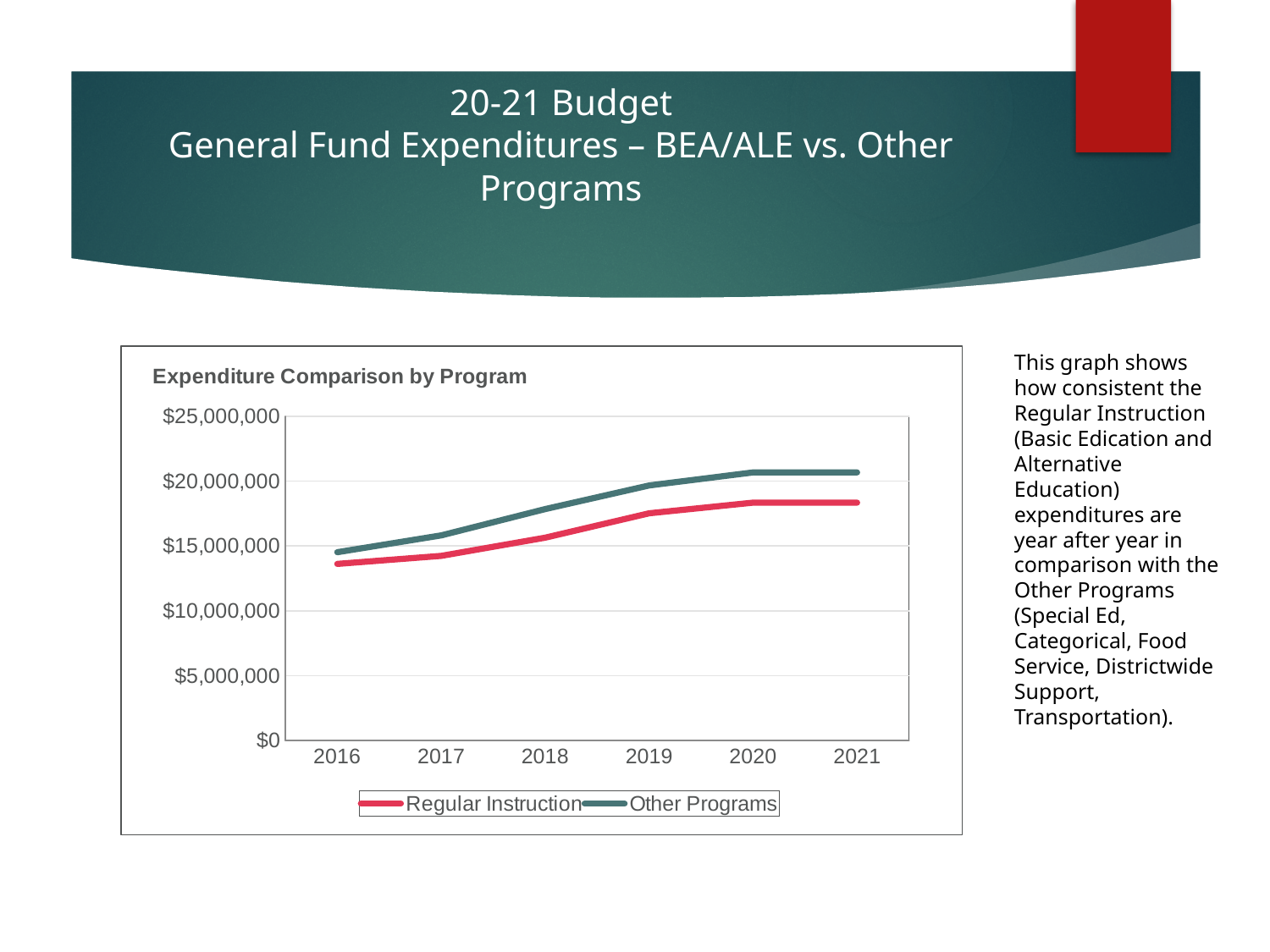
Is the value for Regular Instruction in 2016 greater or less than $15,000,000? less In 2019, which series has the higher value, Regular Instruction or Other Programs? Other Programs Is the value for Other Programs in 2018 greater or less than $15,000,000? greater How many years are plotted along the x axis of the chart? 6 Do the Regular Instruction values generally rise or fall from 2016 to 2021? rise In which year is the Other Programs value lowest? 2016 How many series does the chart legend list? 2 What is the title of the chart? Expenditure Comparison by Program Which series is drawn in red in the chart? Regular Instruction Is the value for Other Programs in 2020 greater or less than $20,000,000? greater What kind of chart is shown on the slide? line chart